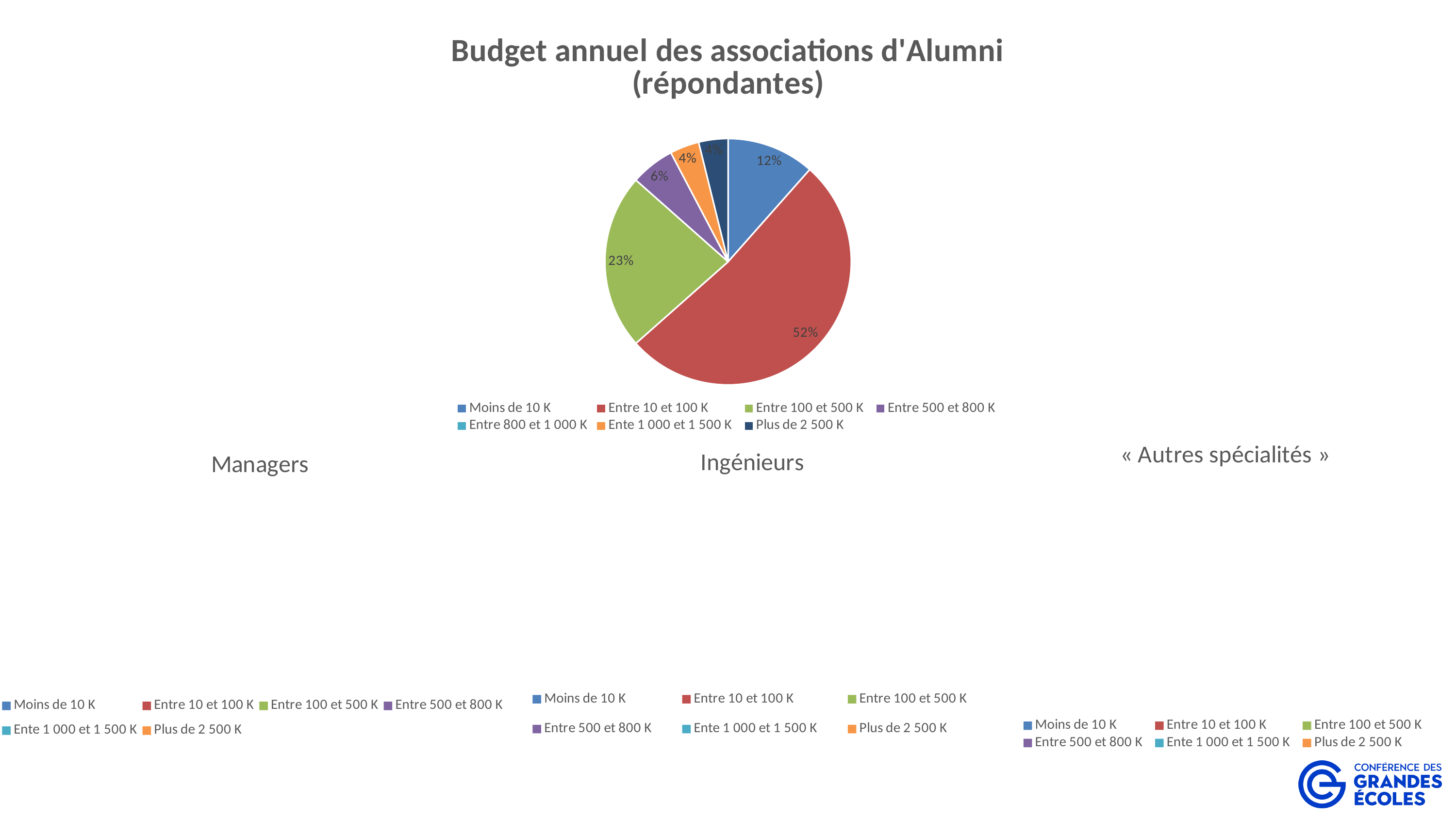
In the pie chart 'Budget annuel des associations d'Alumni (répondantes)', which budget category has the largest slice? Entre 10 et 100 K In the pie chart 'Budget annuel des associations d'Alumni (répondantes)', what percentage is shown for 'Entre 100 et 500 K'? 23% In the pie chart 'Budget annuel des associations d'Alumni (répondantes)', how many slices have a percentage label? 6 How many entries does the legend of the pie chart 'Budget annuel des associations d'Alumni (répondantes)' list? 7 What type of chart is 'Budget annuel des associations d'Alumni (répondantes)'? Pie chart In the pie chart 'Budget annuel des associations d'Alumni (répondantes)', what percentage is shown for 'Moins de 10 K'? 12% In the pie chart 'Budget annuel des associations d'Alumni (répondantes)', which slice is larger: 'Moins de 10 K' or 'Entre 500 et 800 K'? Moins de 10 K What is the title of the pie chart at the top of the slide? Budget annuel des associations d'Alumni (répondantes) In the pie chart 'Budget annuel des associations d'Alumni (répondantes)', what percentage is shown for 'Entre 10 et 100 K'? 52% In the pie chart 'Budget annuel des associations d'Alumni (répondantes)', what is the difference in percentage points between 'Entre 10 et 100 K' and 'Entre 100 et 500 K'? 29 percentage points In the pie chart 'Budget annuel des associations d'Alumni (répondantes)', what colour is the 'Entre 10 et 100 K' slice? Red In the pie chart 'Budget annuel des associations d'Alumni (répondantes)', what percentage is shown for 'Entre 500 et 800 K'? 6%